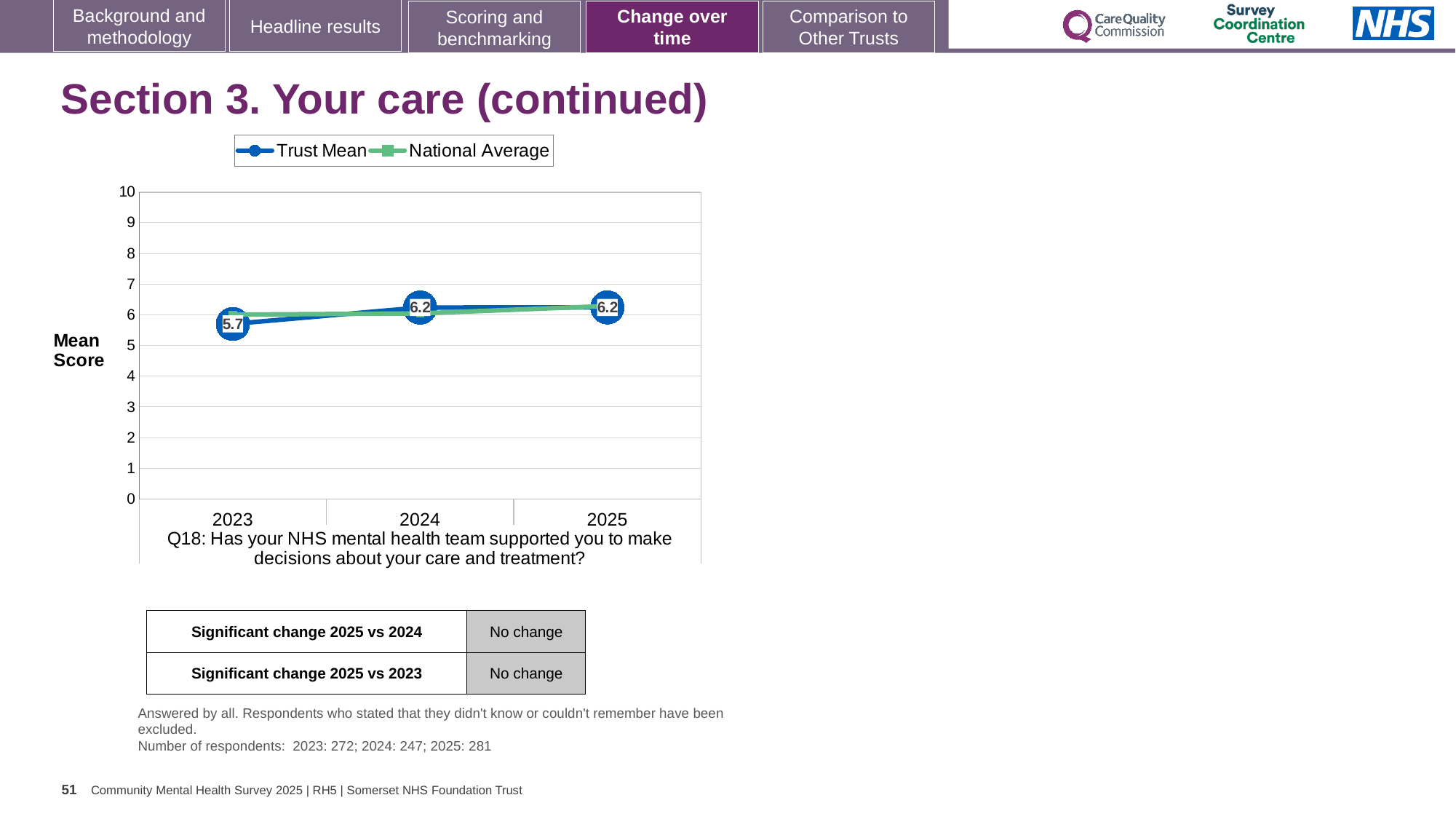
What is the Trust Mean value for 2025? 6.2 What is the Trust Mean value for 2023? 5.7 Does the Trust Mean rise or fall from 2023 to 2025? Rise How many years are plotted on the x axis? 3 Is the National Average value for 2023 greater or less than 5? greater What kind of chart is shown on the slide? Line chart Which is larger, the Trust Mean for 2023 or for 2025? 2025 Is the National Average value for 2025 greater or less than 7? less What is the Trust Mean value for 2024? 6.2 In which year is the Trust Mean lowest? 2023 How many series does the legend list? 2 What is the difference between the Trust Mean in 2024 and in 2023? 0.5